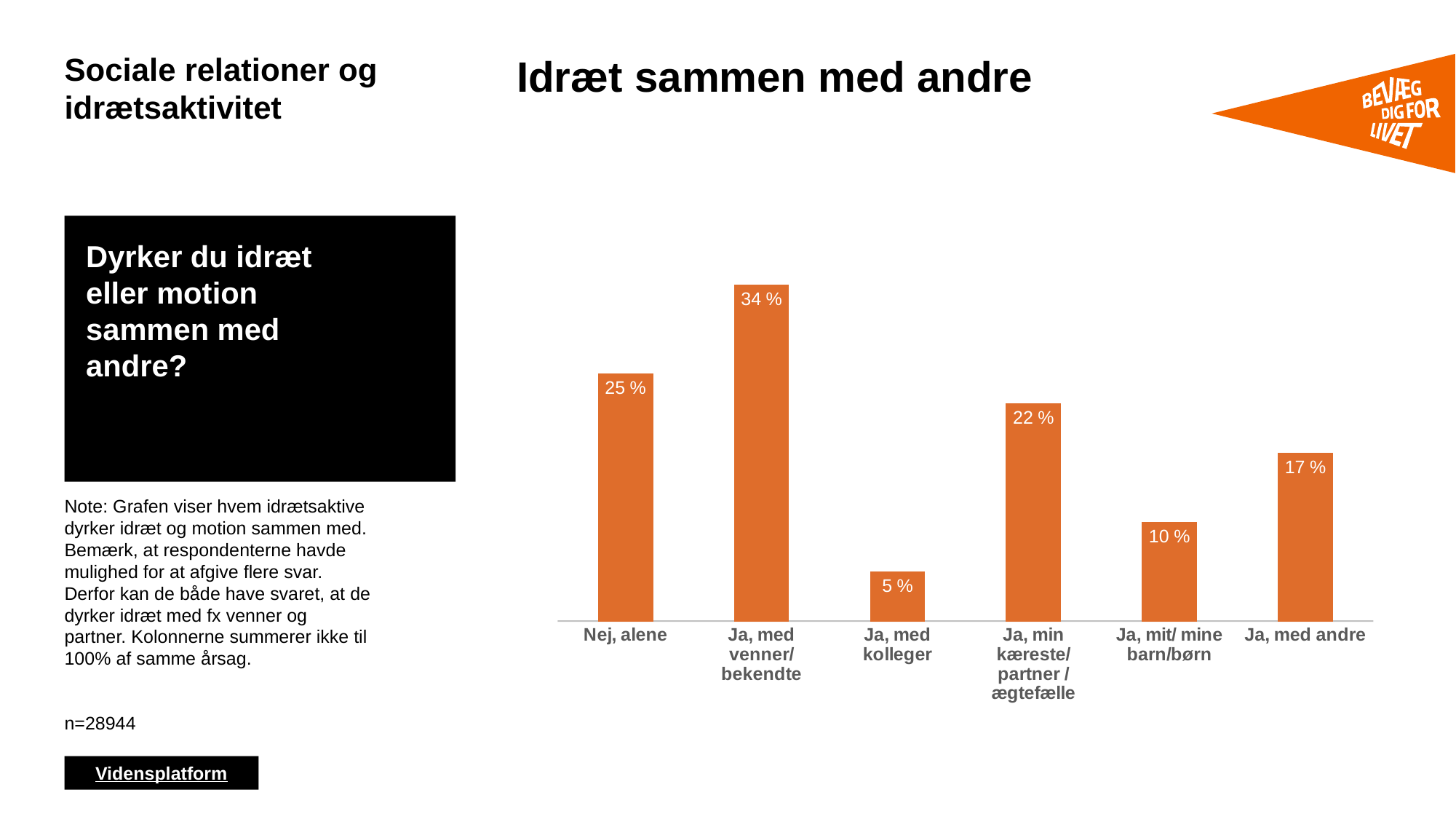
Which category has the lowest value? Ja, med kolleger What kind of chart is shown on the slide? Bar chart What is the title of the chart? Idræt sammen med andre Which category has the highest value? Ja, med venner/ bekendte What is the difference between the values for "Ja, med andre" and "Ja, mit/ mine barn/børn"? 7 % What is the value for "Ja, med venner/ bekendte"? 34 % Which is larger: the value for "Ja, min kæreste/ partner / ægtefælle" or the value for "Ja, med andre"? Ja, min kæreste/ partner / ægtefælle What is the value for "Nej, alene"? 25 % How many categories are shown on the x axis? 6 What is the value for "Ja, mit/ mine barn/børn"? 10 % What is the value for "Ja, med kolleger"? 5 % What is the difference between the values for "Ja, med venner/ bekendte" and "Nej, alene"? 9 %